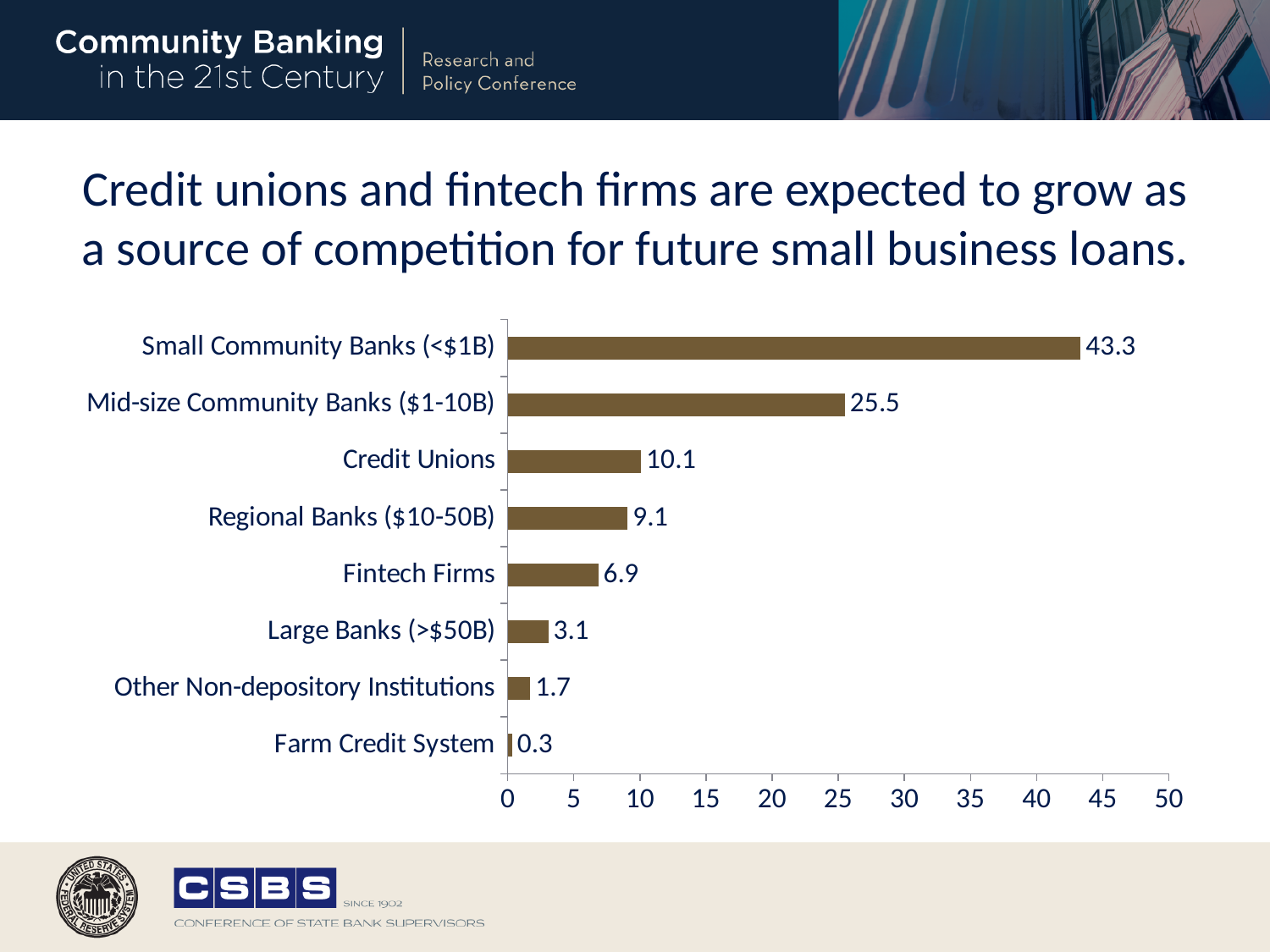
What is the value for Fintech Firms? 6.9 What kind of chart is shown on the slide? bar chart What is the highest value shown on the x axis? 50 Which is larger, the value for Credit Unions or the value for Regional Banks ($10-50B)? Credit Unions Which category has the highest value? Small Community Banks (<$1B) Which category has the lowest value? Farm Credit System What is the difference between the values for Fintech Firms and Other Non-depository Institutions? 5.2 What is the value for Credit Unions? 10.1 What is the value for Large Banks (>$50B)? 3.1 Is the value for Mid-size Community Banks ($1-10B) greater or less than 20? greater What is the difference between the values for Small Community Banks (<$1B) and Mid-size Community Banks ($1-10B)? 17.8 How many categories are shown in the chart? 8